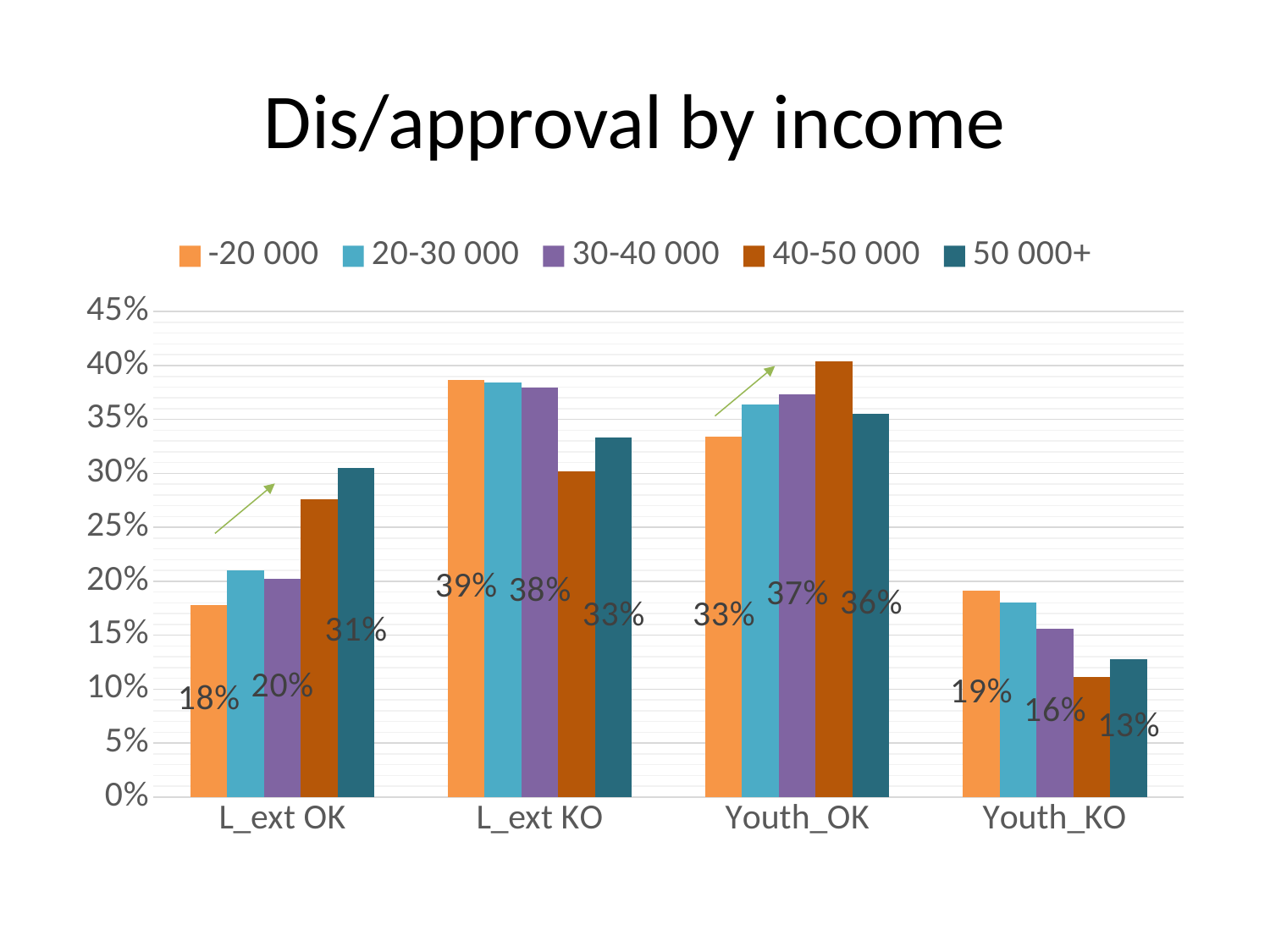
What is the value for the -20 000 income group in the L_ext OK category? 18% What kind of chart is shown on the slide? bar chart Which income group has the lowest value in the Youth_KO category? 40-50 000 What is the value for the -20 000 income group in the L_ext KO category? 39% What is the value for the 50 000+ income group in the Youth_OK category? 36% Which is larger: the -20 000 value for L_ext KO or the -20 000 value for Youth_OK? L_ext KO What is the difference between the 50 000+ and -20 000 values in the L_ext OK category? 13 percentage points Is the value for the 40-50 000 income group in the Youth_KO category greater or less than 15%? less What is the value for the 50 000+ income group in the Youth_KO category? 13% Which income group has the highest value in the Youth_OK category? 40-50 000 How many income groups does the legend list? 5 What is the value for the 50 000+ income group in the L_ext OK category? 31%